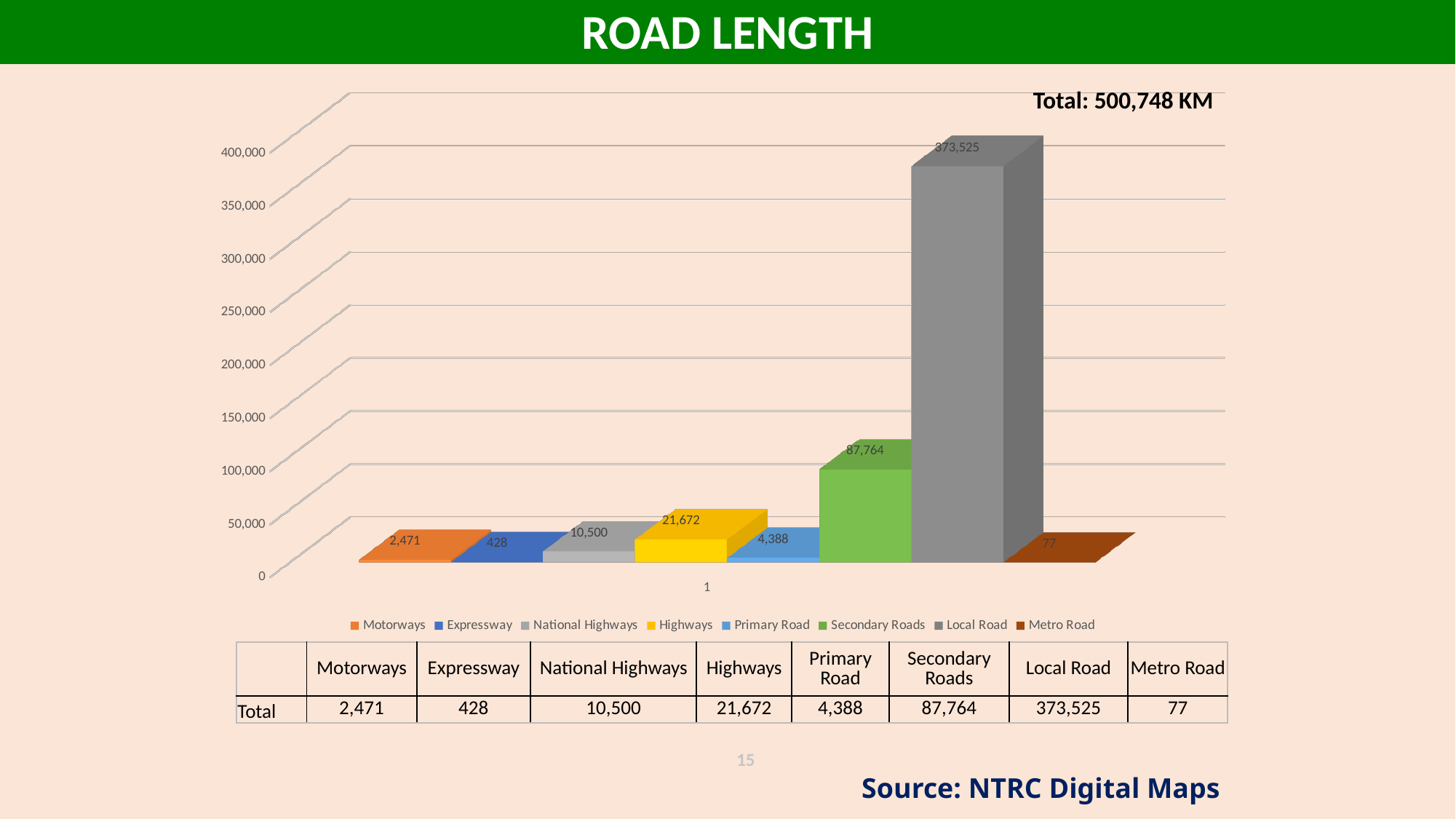
What is the road length for Highways? 21,672 Is the value for Secondary Roads greater or less than 100,000? less How many road categories are shown in the chart? 8 What is the difference in road length between Highways and National Highways? 11,172 What is the road length for Local Road? 373,525 What kind of chart is shown on the slide? bar chart Which has a greater road length, Primary Road or Motorways? Primary Road What is the road length for Expressway? 428 What total road length is stated on the slide? 500,748 KM Which road category has the lowest road length? Metro Road Which road category has the highest road length? Local Road What is the difference in road length between Local Road and Secondary Roads? 285,761